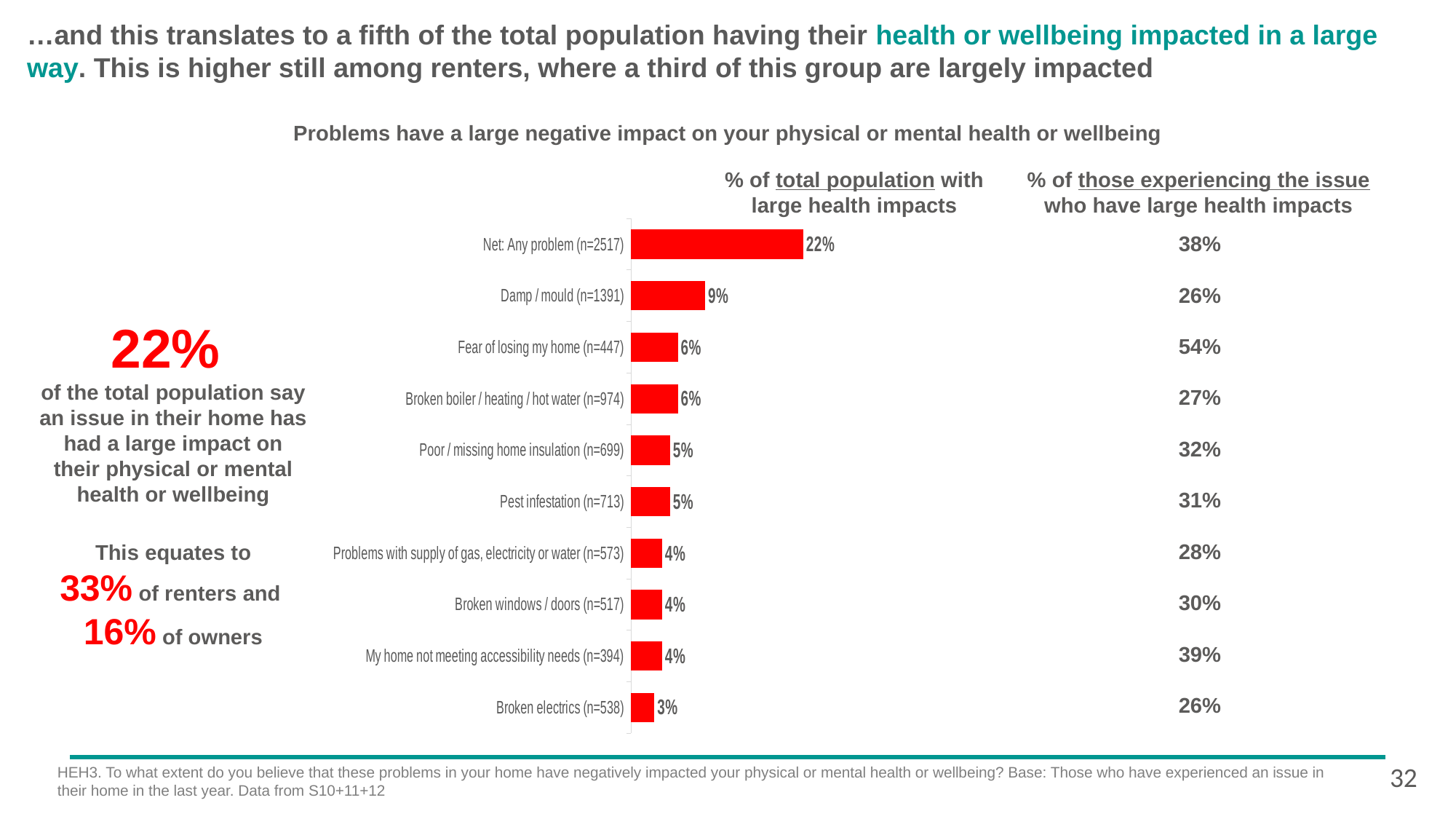
What colour are the bars in the chart? Red Which category has the highest value in the bar chart showing % of total population with large health impacts? Net: Any problem (n=2517) What is the title of the chart on the slide? Problems have a large negative impact on your physical or mental health or wellbeing What is the difference between the values for Fear of losing my home (n=447) and Broken electrics (n=538) in the bar chart? 3% How many categories are plotted in the bar chart? 10 What is the value for Pest infestation (n=713) in the bar chart showing % of total population with large health impacts? 5% Which category has the lowest value in the bar chart showing % of total population with large health impacts? Broken electrics (n=538) What is the value for Damp / mould (n=1391) in the bar chart showing % of total population with large health impacts? 9% What is the value for Broken electrics (n=538) in the bar chart showing % of total population with large health impacts? 3% What is the difference between the values for Net: Any problem (n=2517) and Damp / mould (n=1391) in the bar chart? 13% What kind of chart is shown on the slide? Bar chart In the bar chart, which is larger: the value for Damp / mould (n=1391) or the value for Fear of losing my home (n=447)? Damp / mould (n=1391)